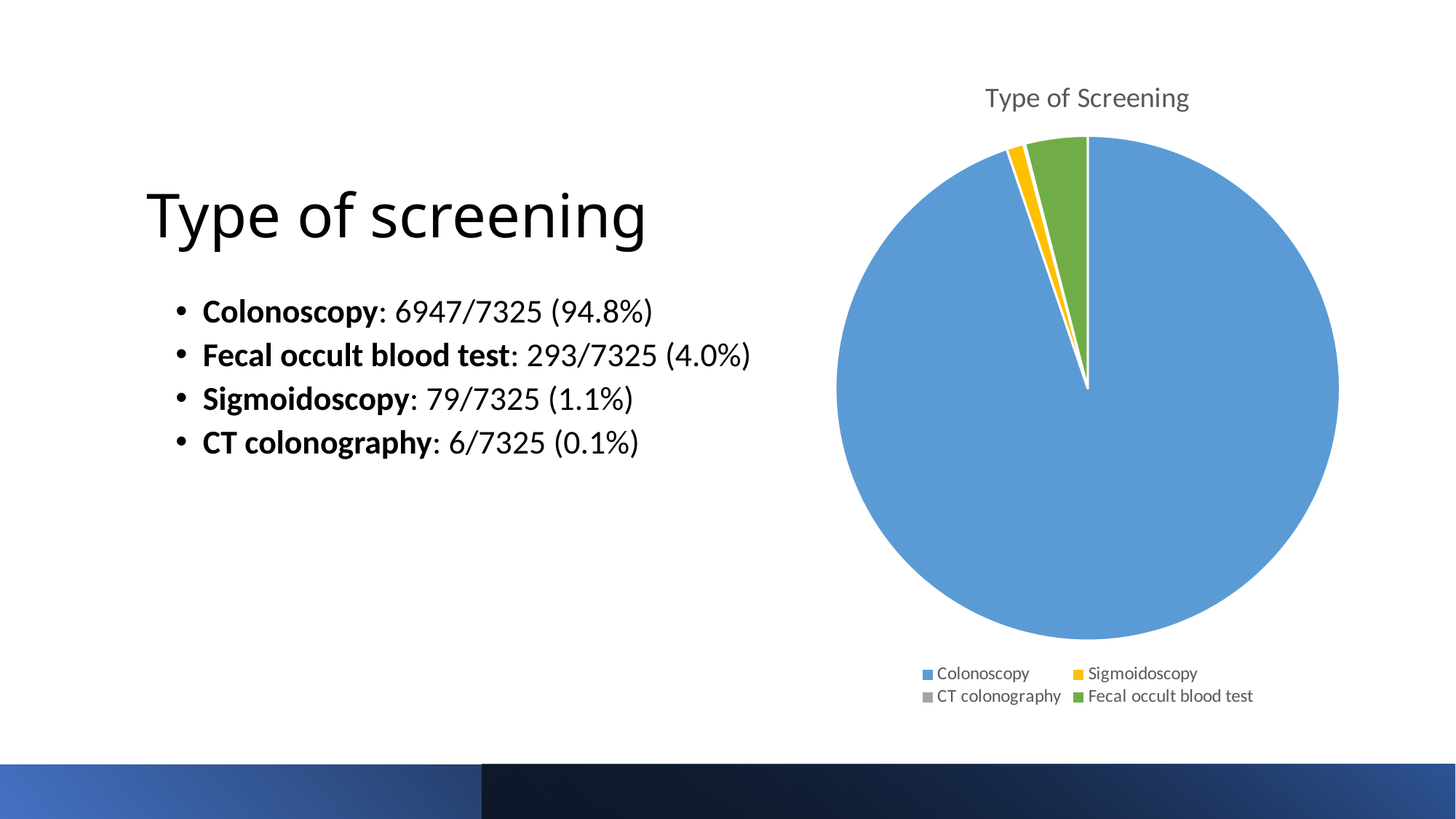
Which screening type has the largest slice of the pie chart? Colonoscopy What is the title of the chart? Type of Screening What share of the pie does Colonoscopy represent, according to the slide? 94.8% How many categories does the legend of the pie chart list? 4 What kind of chart is shown on the slide? pie chart How many screenings were Colonoscopy, according to the slide? 6947 What share of the pie does Fecal occult blood test represent, according to the slide? 4.0% Which screening type has the smallest slice of the pie chart? CT colonography Which slice is larger in the pie chart, Sigmoidoscopy or Fecal occult blood test? Fecal occult blood test What share of the pie does Sigmoidoscopy represent, according to the slide? 1.1% What is the difference in count between Fecal occult blood test and Sigmoidoscopy screenings, according to the slide? 214 Which colour represents Sigmoidoscopy in the pie chart? yellow